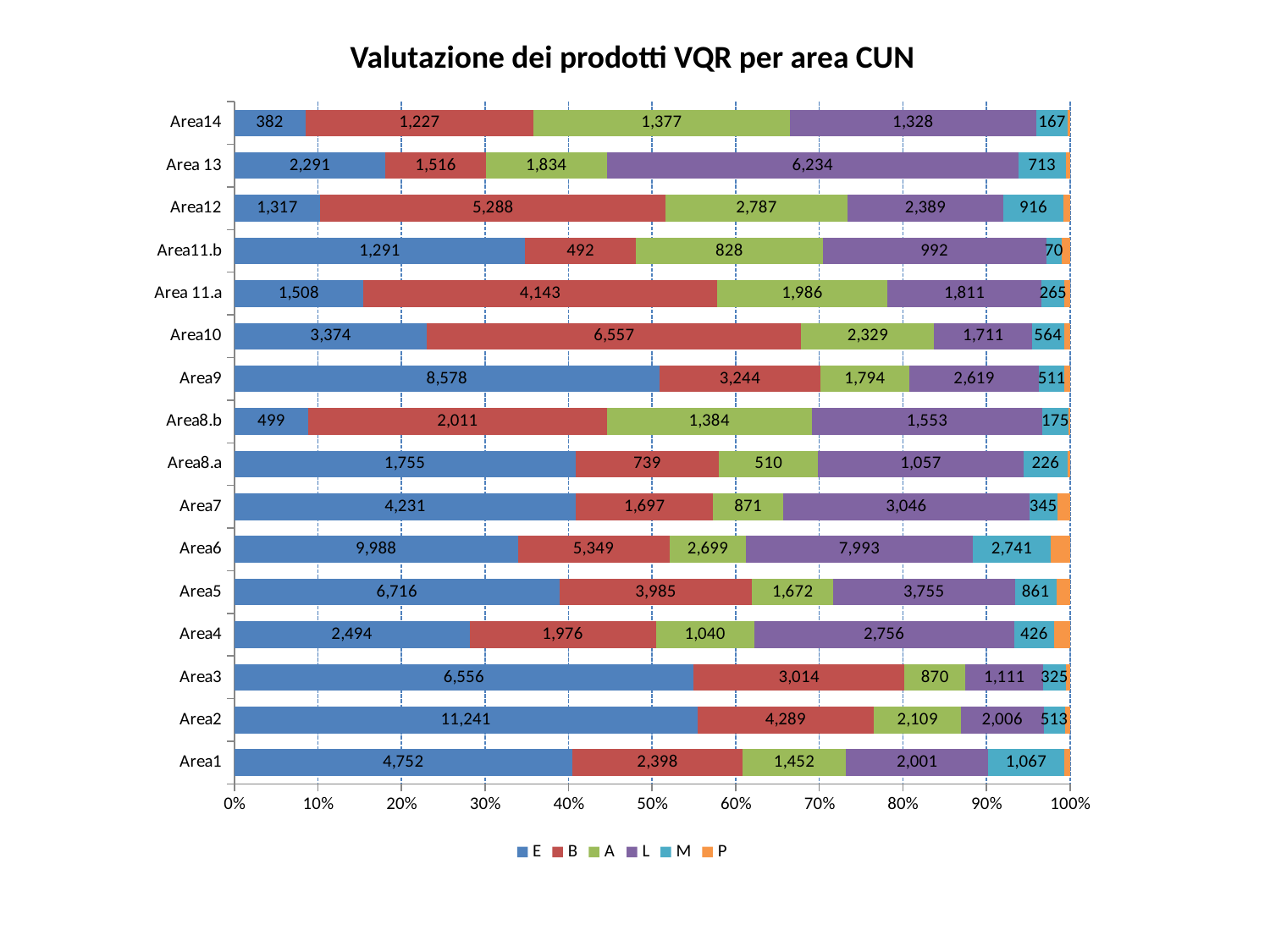
What kind of chart is shown on the slide? Stacked bar chart Which area has the largest value for series E? Area2 What is the value of series E for Area2? 11,241 What is the value of series M for Area6? 2,741 What is the difference between the E value and the B value for Area9? 5,334 What is the value of series B for Area10? 6,557 How many areas (categories) are shown on the chart? 16 Which area has the smallest value for series E? Area14 What is the value of series L for Area 13? 6,234 How many series does the legend list? 6 Which is larger: the B value for Area12 or the B value for Area 11.a? Area12 What is the value of series A for Area14? 1,377